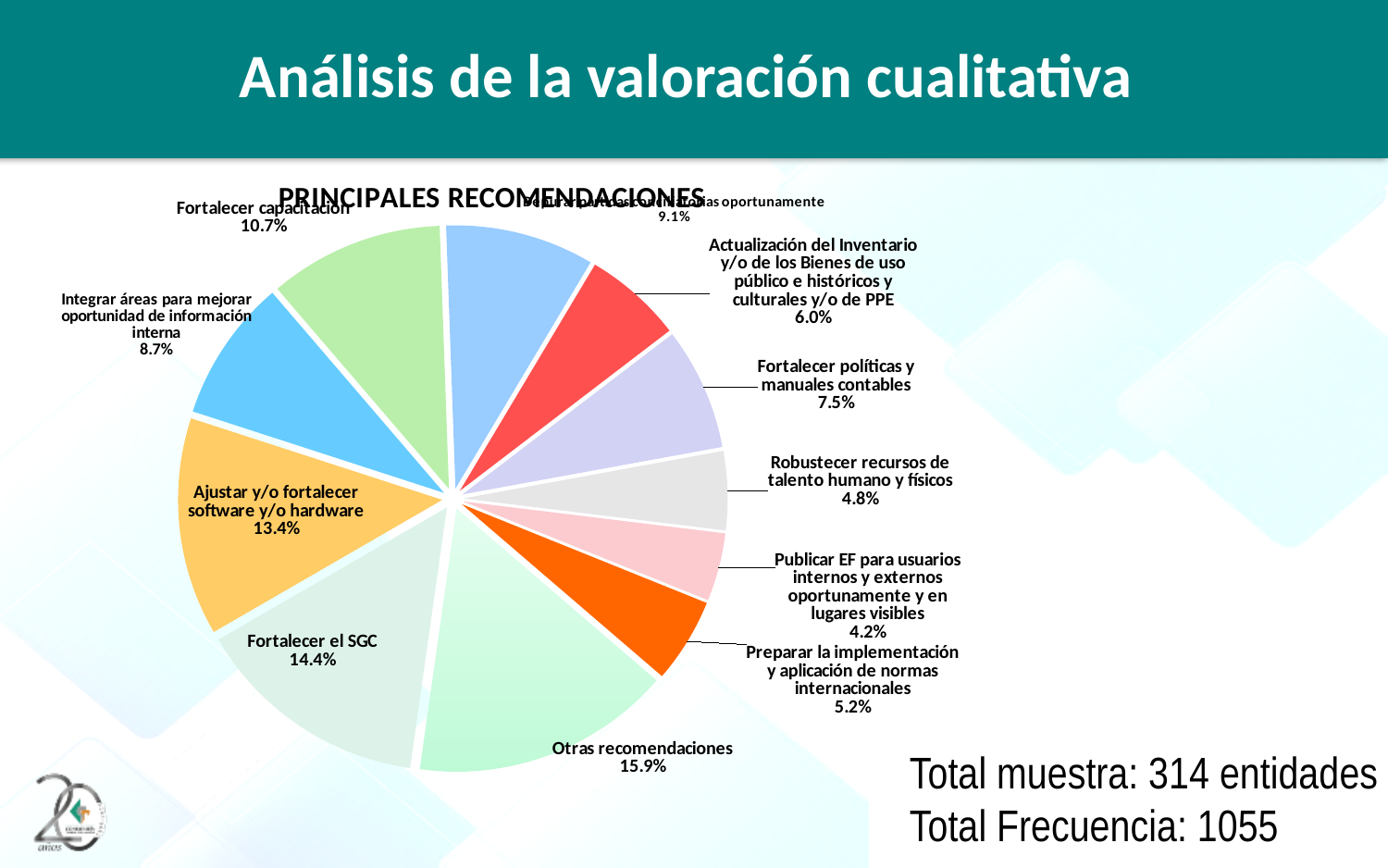
What is the difference in percentage points between "Fortalecer el SGC" and "Fortalecer capacitación"? 3.7 What percentage is shown for "Fortalecer el SGC"? 14.4% Which category has the largest share of the pie? Otras recomendaciones Which category has the smallest share of the pie? Publicar EF para usuarios internos y externos oportunamente y en lugares visibles What share of the pie does "Preparar la implementación y aplicación de normas internacionales" represent? 5.2% How many slices does the pie chart have? 11 What percentage is shown for "Ajustar y/o fortalecer software y/o hardware"? 13.4% What percentage is shown for "Fortalecer políticas y manuales contables"? 7.5% What kind of chart is shown on the slide? Pie chart What percentage is shown for "Robustecer recursos de talento humano y físicos"? 4.8% What is the title of the chart? PRINCIPALES RECOMENDACIONES Which is larger: "Integrar áreas para mejorar oportunidad de información interna" or "Actualización del Inventario y/o de los Bienes de uso público e históricos y culturales y/o de PPE"? Integrar áreas para mejorar oportunidad de información interna